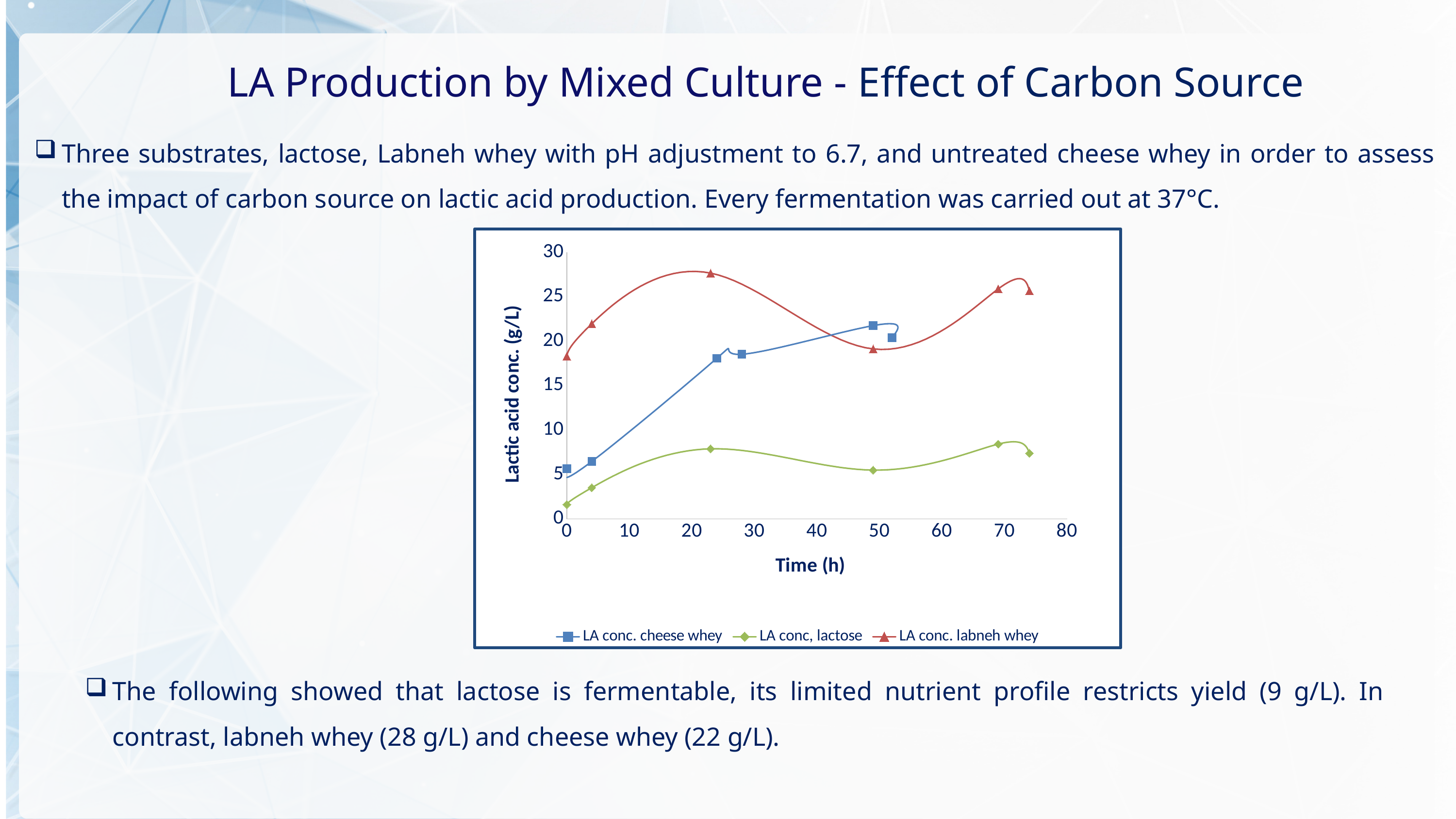
At time 0 h, which series has the higher lactic acid concentration: LA conc. labneh whey or LA conc. cheese whey? LA conc. labneh whey Is the highest lactic acid concentration for LA conc, lactose greater or less than 10? less Does the LA conc. cheese whey series generally rise or fall between 0 h and 50 h? rise What is the label of the y axis? Lactic acid conc. (g/L) Which series stays lowest throughout the chart? LA conc, lactose Is the lactic acid concentration for LA conc, lactose at time 0 h greater or less than 5? less What kind of chart is shown on the slide? line chart What is the label of the x axis? Time (h) How many series does the chart legend list? 3 Which series reaches the highest lactic acid concentration on the chart? LA conc. labneh whey Is the peak lactic acid concentration for LA conc. labneh whey greater or less than 25? greater